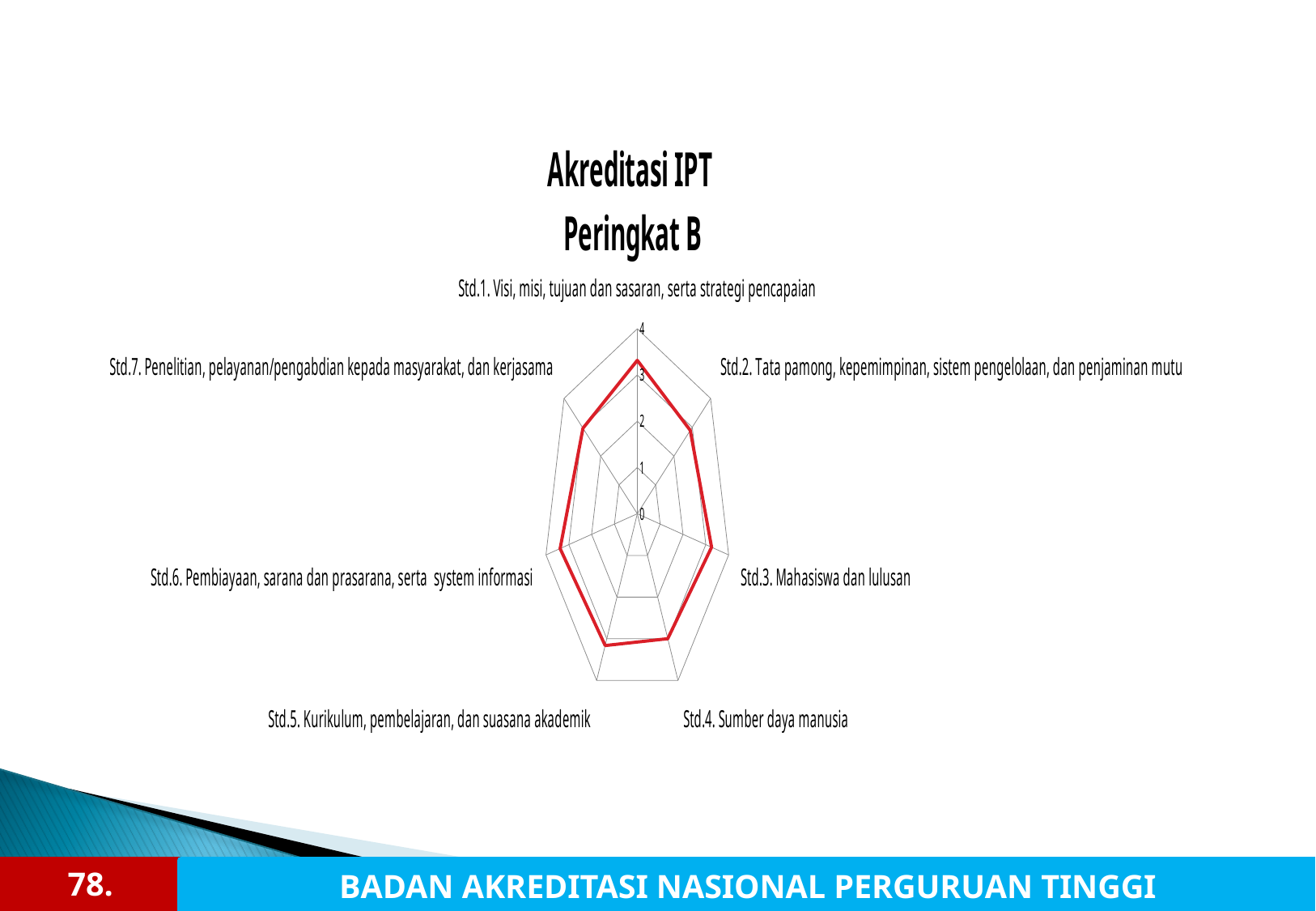
Is the value for Std.6 (Pembiayaan, sarana dan prasarana, serta system informasi) greater or less than 2? greater Is the value for Std.4 (Sumber daya manusia) greater or less than 4? less Is the value for Std.1 (Visi, misi, tujuan dan sasaran, serta strategi pencapaian) greater or less than 2? greater What is the highest value shown on the chart's axis scale? 4 How many standards (categories) are plotted on the radar chart? 7 What is the title of the chart? Akreditasi IPT Peringkat B What kind of chart is shown on the slide? radar chart